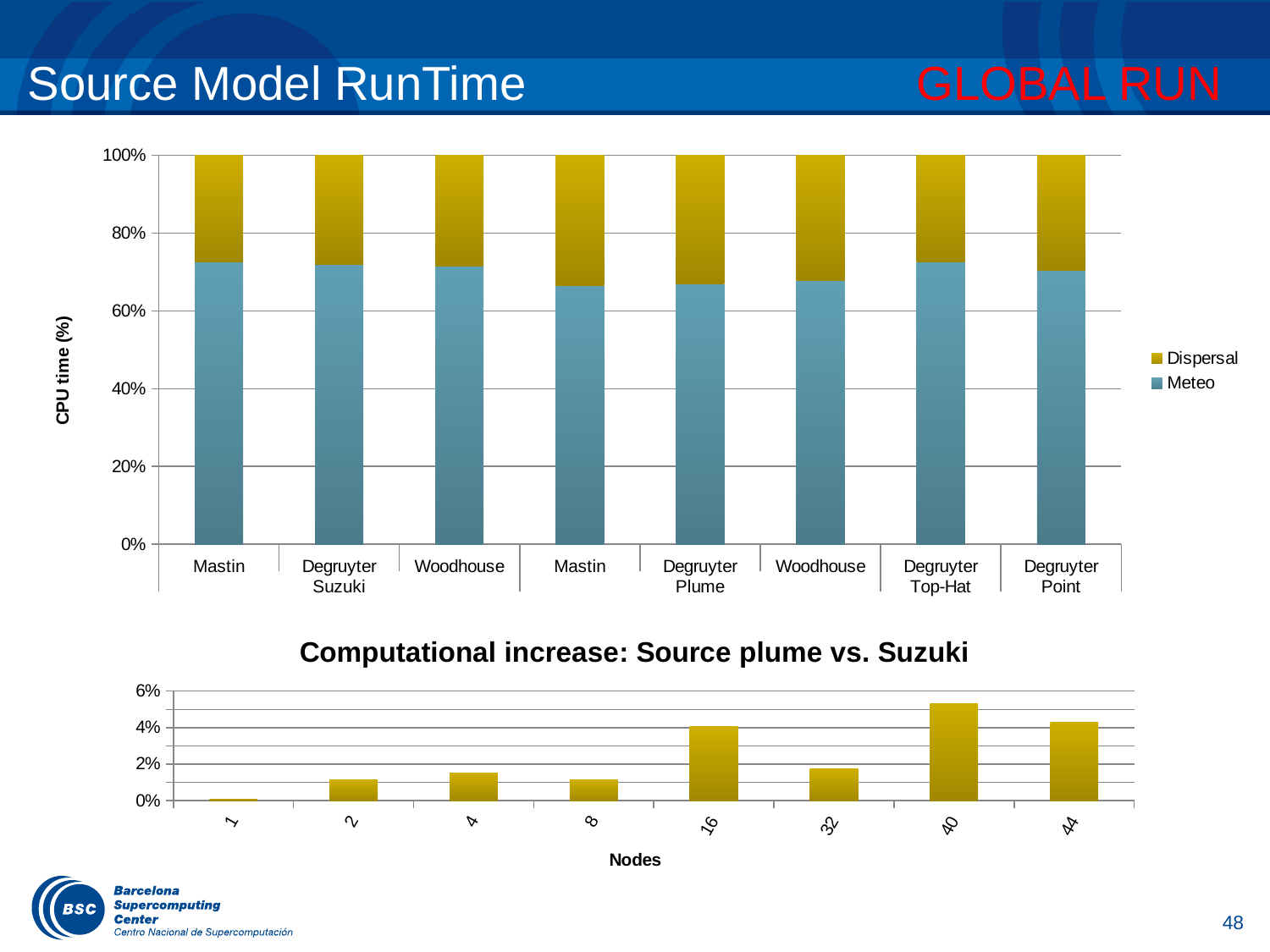
In the bottom chart 'Computational increase: Source plume vs. Suzuki', is the value for 16 nodes greater or less than 2%? greater How many series does the legend of the top chart list? 2 What is the title of the bottom chart? Computational increase: Source plume vs. Suzuki In the bottom chart 'Computational increase: Source plume vs. Suzuki', how many node categories are shown on the x axis? 8 What kind of chart is the top chart on the slide? stacked bar chart In the top chart, is the Meteo value for the first Mastin bar greater or less than 60%? greater In the bottom chart 'Computational increase: Source plume vs. Suzuki', which number of nodes has the lowest value? 1 In the top chart, what is the total height of the stacked bar for Degruyter Top-Hat? 100% What are the two series named in the legend of the top chart? Dispersal and Meteo In the bottom chart 'Computational increase: Source plume vs. Suzuki', which is larger, the value for 16 nodes or the value for 32 nodes? 16 nodes In the bottom chart 'Computational increase: Source plume vs. Suzuki', which number of nodes has the highest value? 40 How many bars are plotted in the top chart? 8